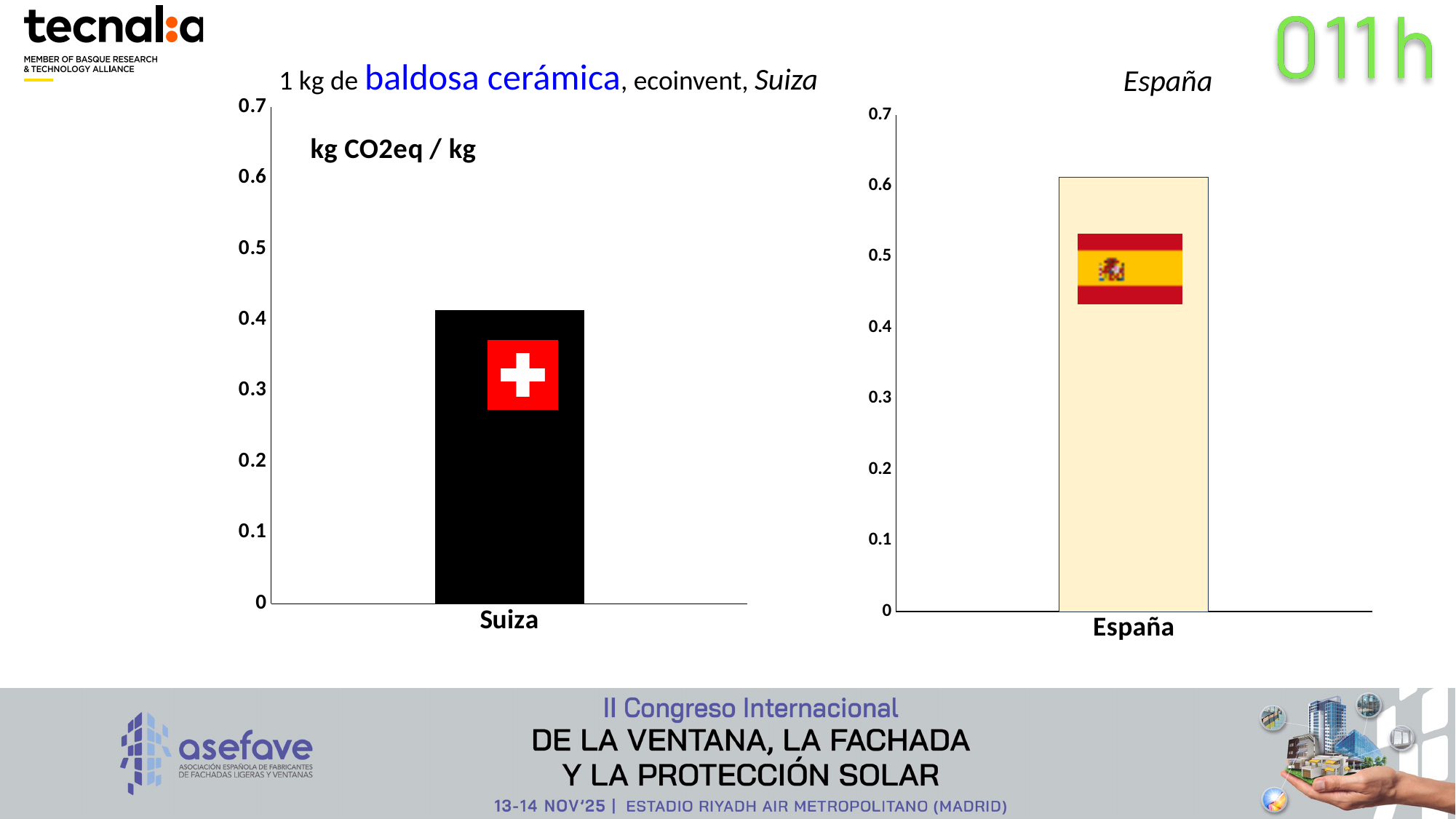
In the left chart, is the value for Suiza greater or less than 0.5? less In the right chart, is the value for España greater or less than 0.5? greater What kind of chart is the right chart titled 'España'? bar chart In the left chart, is the value for Suiza greater or less than 0.3? greater How many bars are plotted in the right chart titled 'España'? 1 What is the highest value shown on the y axis of the left chart? 0.7 Comparing the two charts, which bar is taller, Suiza or España? España How many bars are plotted in the left chart titled 'Suiza'? 1 What unit is shown on the left chart? kg CO2eq / kg What kind of chart is the left chart titled 'Suiza'? bar chart